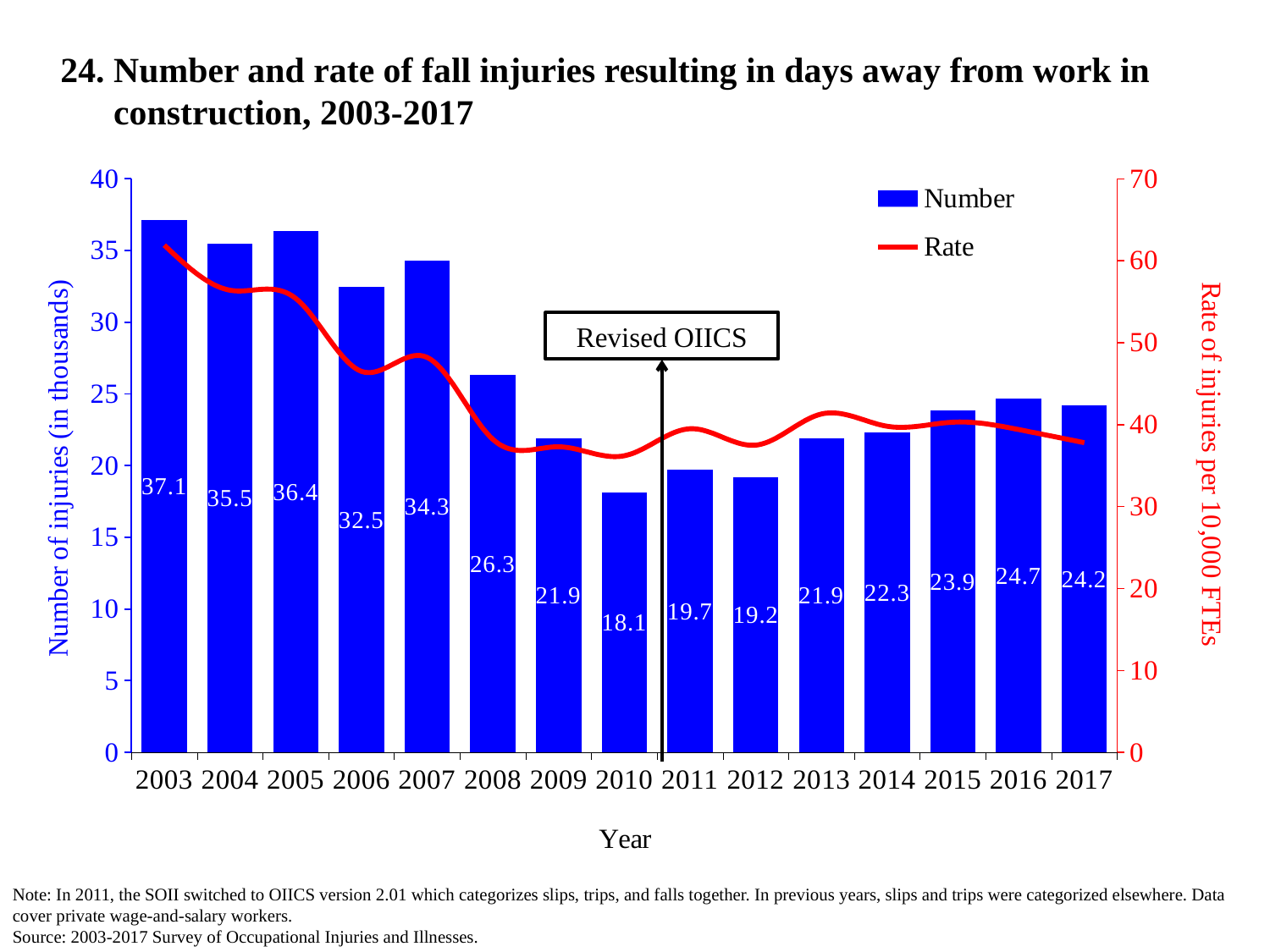
What is the number of fall injuries (in thousands) in 2016? 24.7 Is the rate of fall injuries per 10,000 FTEs in 2003 greater or less than 50? greater How many years are shown on the x axis? 15 What is the number of fall injuries (in thousands) in 2003? 37.1 What is the difference between the number of fall injuries in 2003 and in 2010 (in thousands)? 19 What is the number of fall injuries (in thousands) in 2010? 18.1 How many series does the legend list? 2 Which year has a larger number of fall injuries, 2005 or 2007? 2005 What label is shown in the box with the arrow pointing to the x axis between 2010 and 2011? Revised OIICS Is the rate of fall injuries per 10,000 FTEs in 2010 greater or less than 40? less Which year has the highest number of fall injuries? 2003 Which year has the lowest number of fall injuries? 2010